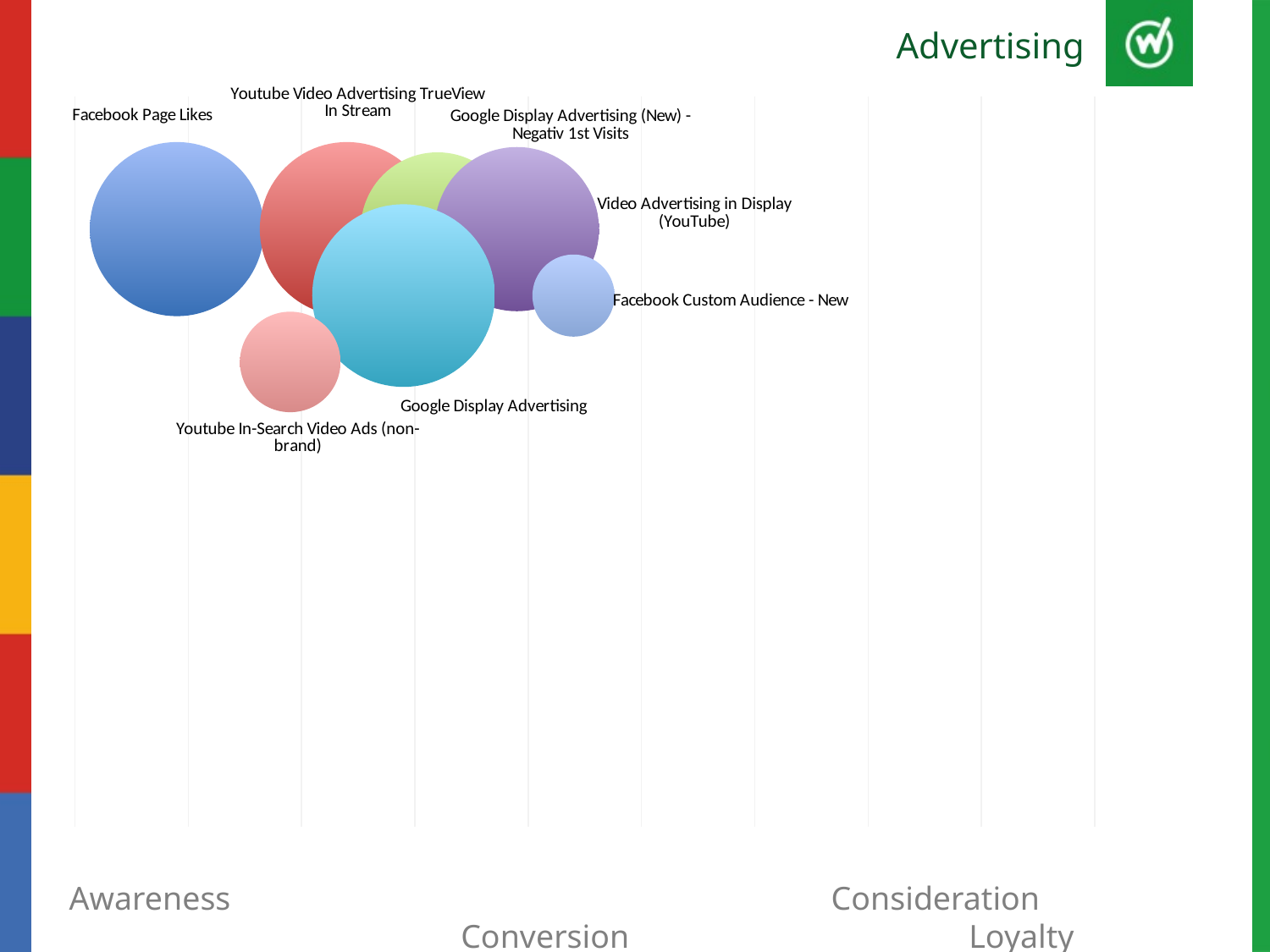
Which bubble is larger, Facebook Page Likes or Facebook Custom Audience - New? Facebook Page Likes Which bubble is positioned furthest to the right on the chart? Facebook Custom Audience - New What is the title of the slide containing the chart? Advertising What kind of chart is shown on the slide? Bubble chart What colour is the Facebook Page Likes bubble? Blue Which bubble is positioned furthest to the left on the chart? Facebook Page Likes How many labelled bubbles are plotted on the chart? 7 Which bubble on the chart is the smallest? Facebook Custom Audience - New